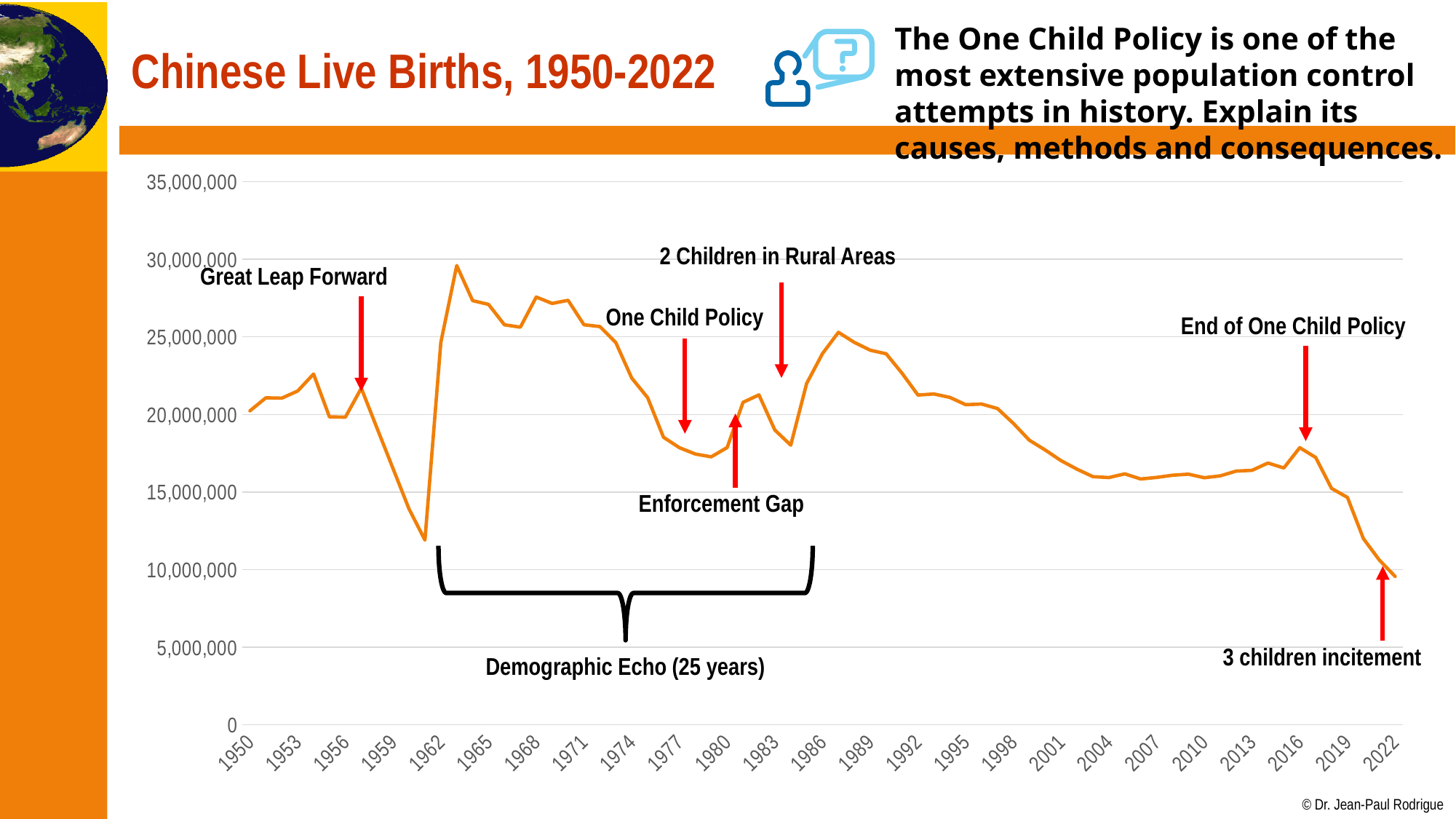
Is the value for 1968 greater or less than 25,000,000? greater Do live births rise or fall between 2016 and 2022? Fall What is the title of the chart? Chinese Live Births, 1950-2022 What kind of chart is shown on the slide? Line chart Is the value for 1992 greater or less than 20,000,000? greater Is the value for 2022 greater or less than 15,000,000? less How many year labels are shown on the x axis? 25 How many years does the 'Demographic Echo' bracket annotation say it spans? 25 years Which year has more live births, 1968 or 2010? 1968 Which year on the x axis has the lowest number of live births? 2022